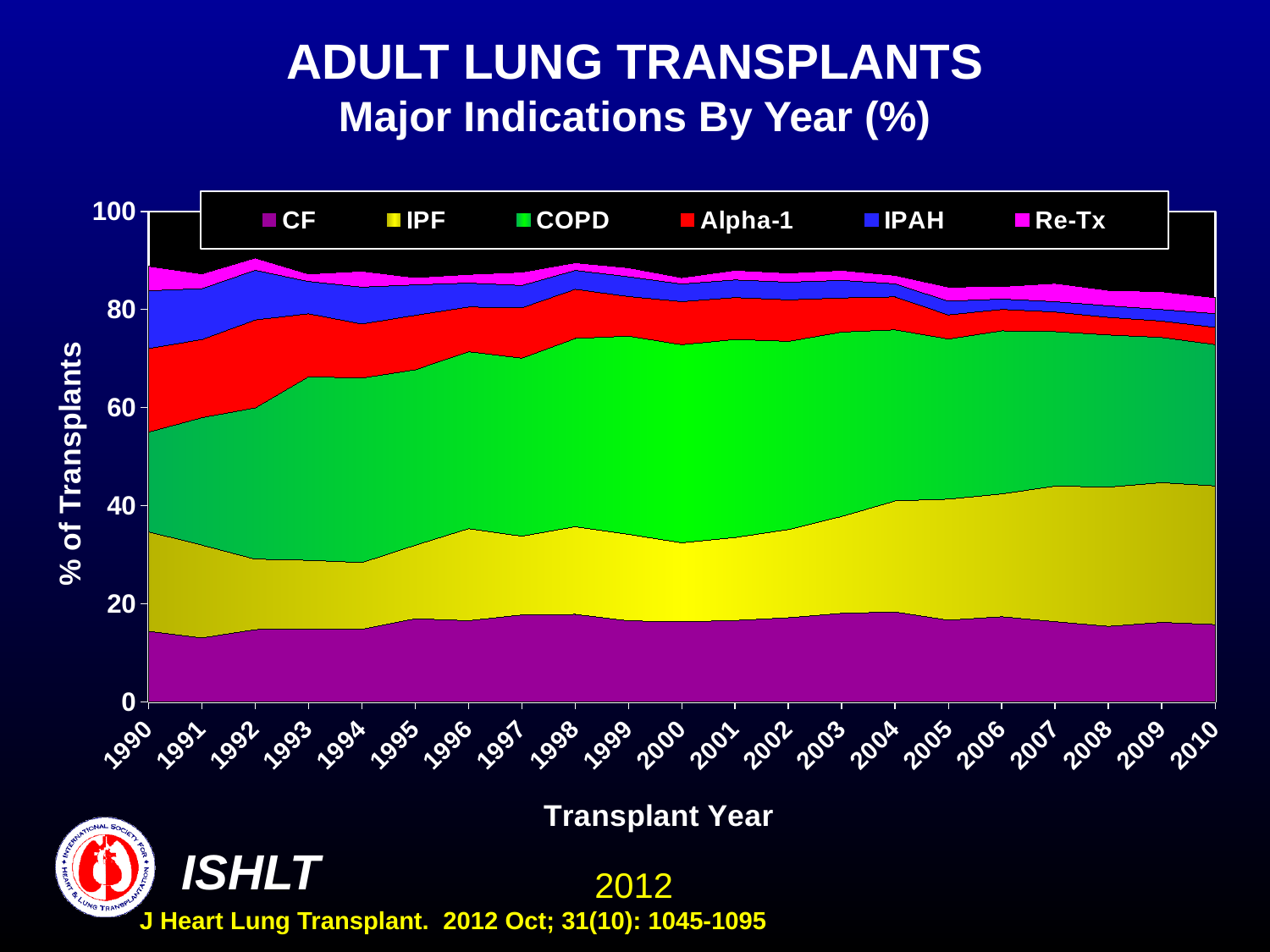
What kind of chart is shown on the slide? stacked area chart In 1990, is the top of the CF band greater or less than 20? less What is the label of the y axis? % of Transplants How many transplant years are plotted along the x axis? 21 In 2010, is the cumulative top of the COPD band greater or less than 80? less How many series does the legend list? 6 Which indication is listed first in the legend? CF In 2010, is the cumulative top of the IPF band greater or less than 40? greater What is the first year shown on the x axis? 1990 Does the combined share of the six major indications (the top of the stacked area) rise or fall from 1990 to 2010? fall What is the last year shown on the x axis? 2010